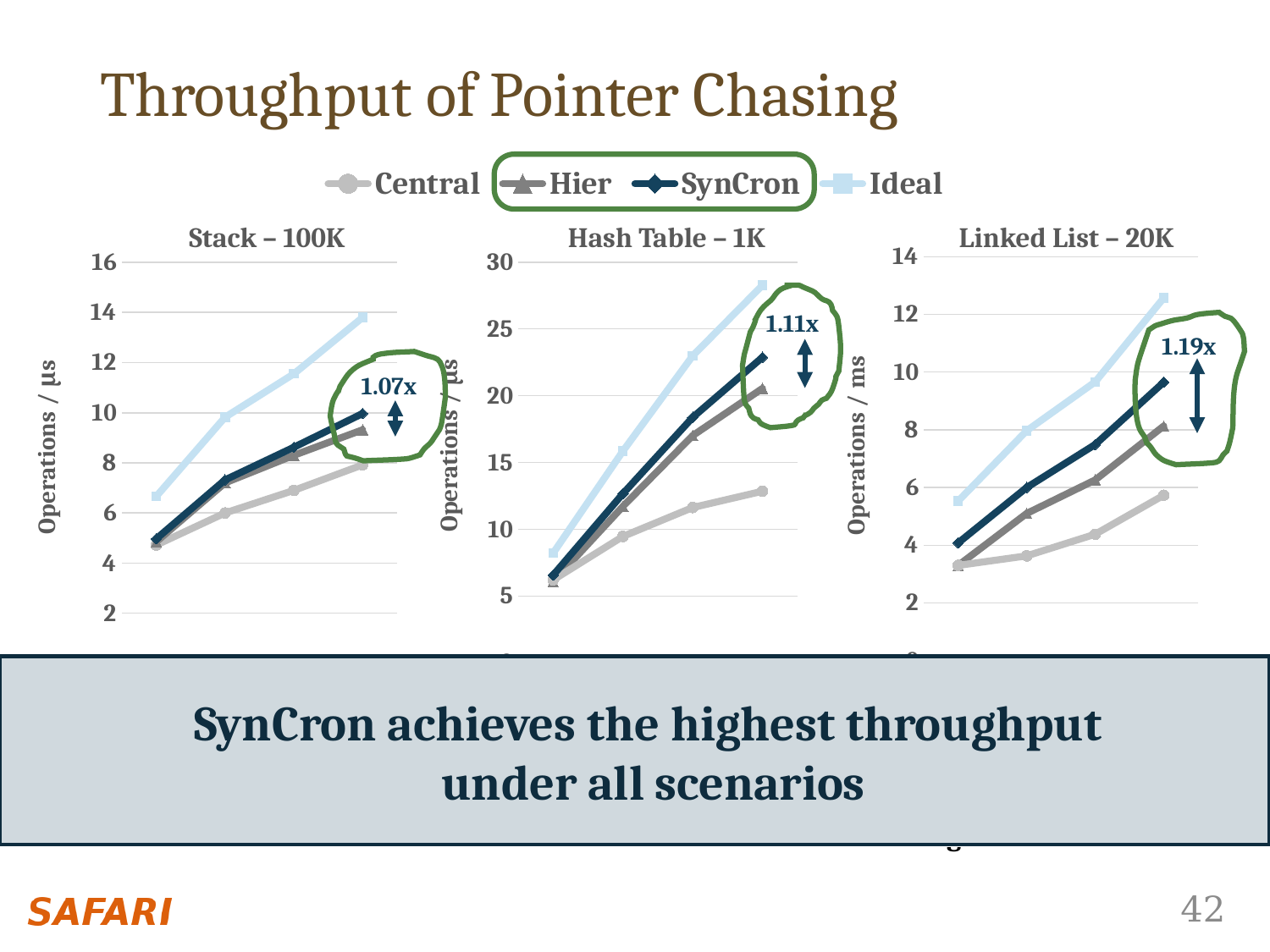
What kind of chart is the Stack – 100K chart? line chart In the Hash Table – 1K chart, which series has the highest values? Ideal What factor is annotated next to the circled region on the Stack – 100K chart? 1.07x What factor is annotated next to the circled region on the Linked List – 20K chart? 1.19x What factor is annotated next to the circled region on the Hash Table – 1K chart? 1.11x In the Linked List – 20K chart, which series has the lowest values? Central How many charts are shown on the slide? 3 In the Hash Table – 1K chart, is the rightmost value for Ideal greater or less than 25? greater In the Linked List – 20K chart, at the rightmost point, which is larger: SynCron or Hier? SynCron How many series does the shared legend list? 4 What is the y-axis label of the Linked List – 20K chart? Operations / ms In the Hash Table – 1K chart, is the rightmost value for Central greater or less than 15? less